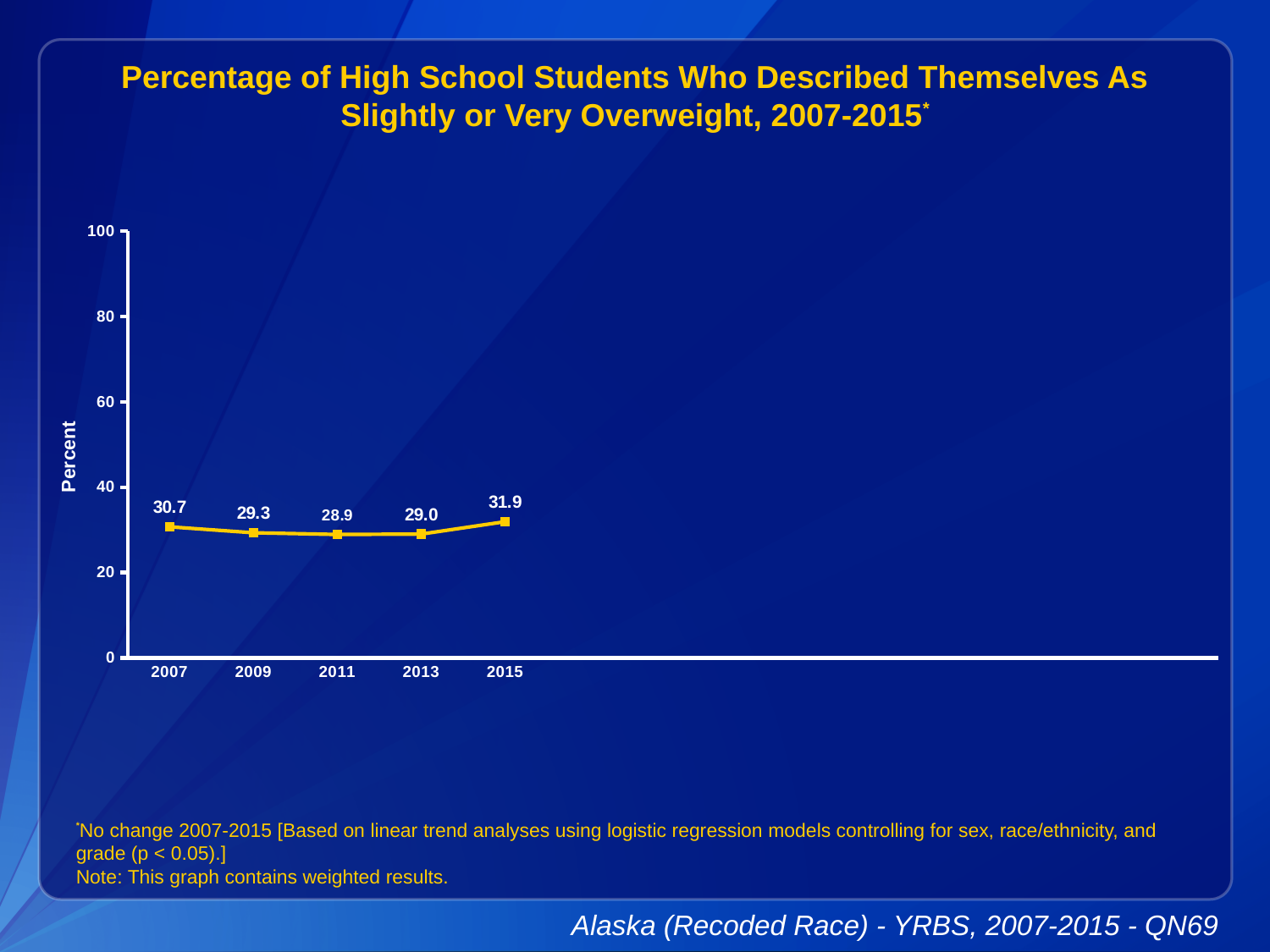
Is the value for 2015 greater or less than 40? less Which year has the lowest value? 2011 What is the value for 2011? 28.9 What kind of chart is shown on the slide? line chart How many years are plotted on the chart? 5 What is the value for 2007? 30.7 What is the value for 2015? 31.9 What is the label on the y axis? Percent Which year has the highest value? 2015 What is the difference between the values for 2009 and 2011? 0.4 What is the difference between the values for 2015 and 2007? 1.2 Which is larger, the value for 2007 or the value for 2013? 2007